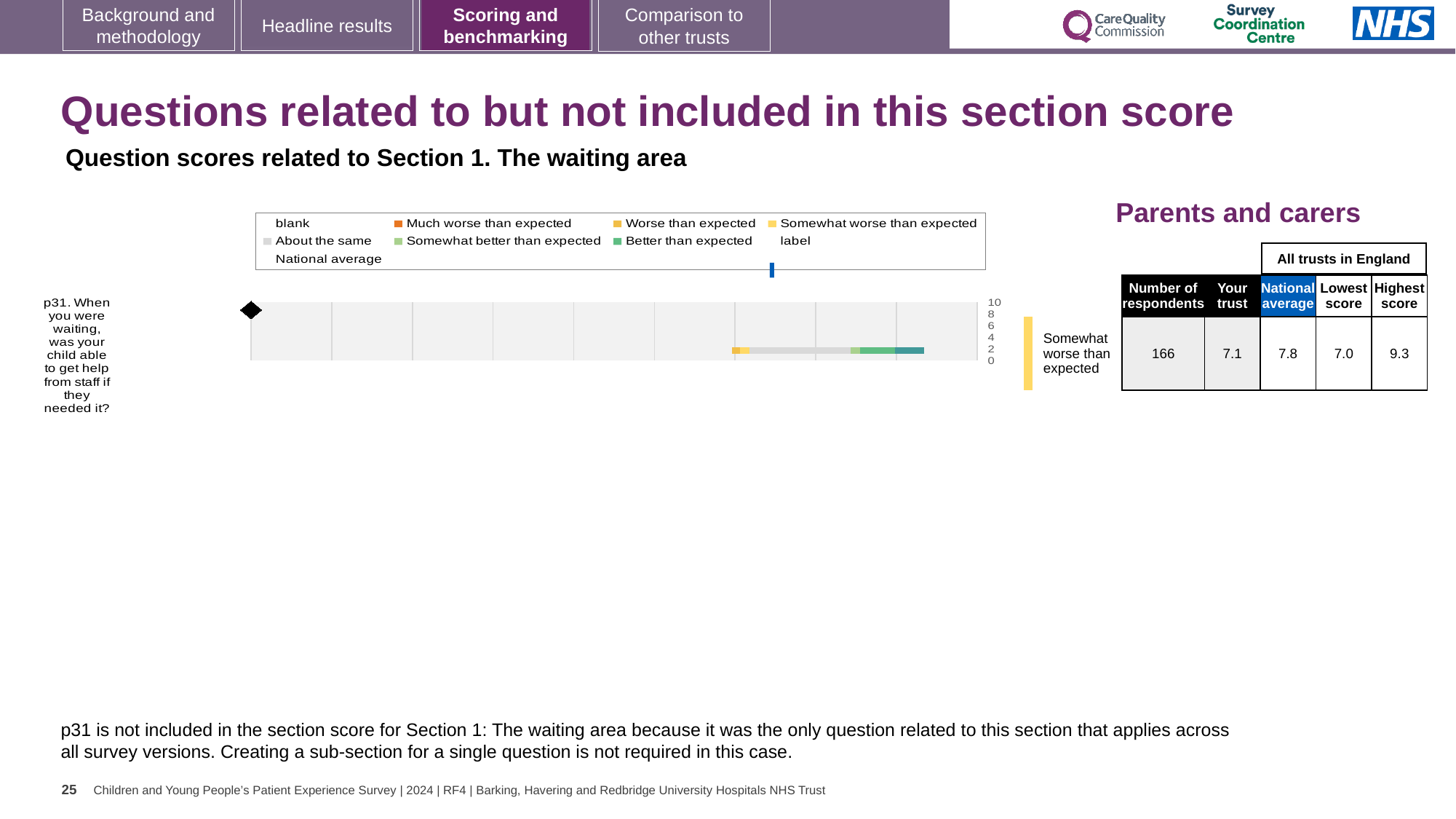
What is the lowest score among all trusts in England for question p31? 7.0 Which is larger for question p31, the 'Your trust' score or the national average? National average How many questions are plotted in the chart? 1 What kind of chart is used to show the score for question p31? bar chart What is the national average score for question p31? 7.8 What is the highest score among all trusts in England for question p31? 9.3 What is the difference between the national average and the 'Your trust' score for question p31? 0.7 Which question is plotted in the chart? p31. When you were waiting, was your child able to get help from staff if they needed it? How many respondents answered question p31? 166 What benchmark category is shown next to the chart for question p31? Somewhat worse than expected What is the difference between the highest and lowest scores among all trusts in England for question p31? 2.3 What is the 'Your trust' score for question p31? 7.1